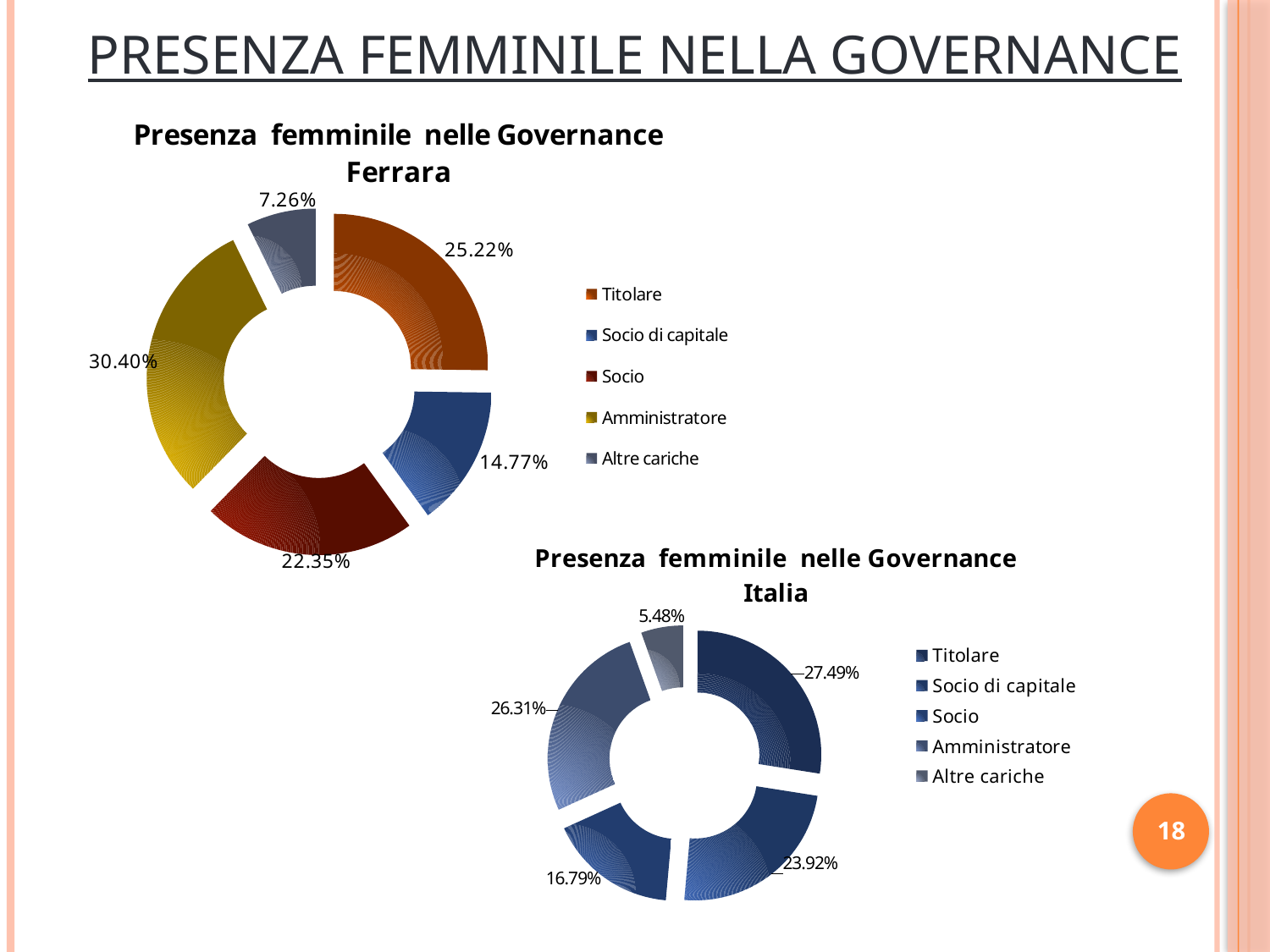
What kind of chart is the 'Presenza femminile nelle Governance Ferrara' chart? Doughnut (pie) chart In the 'Presenza femminile nelle Governance Ferrara' chart, what colour is the Amministratore slice? Yellow In the 'Presenza femminile nelle Governance Ferrara' chart, what is the value for Titolare? 25.22% In the 'Presenza femminile nelle Governance Italia' chart, which category has the largest share? Titolare In the 'Presenza femminile nelle Governance Italia' chart, what is the value for Altre cariche? 5.48% In the 'Presenza femminile nelle Governance Ferrara' chart, what is the value for Amministratore? 30.40% In the 'Presenza femminile nelle Governance Italia' chart, which is larger, Socio di capitale or Socio? Socio di capitale In the 'Presenza femminile nelle Governance Ferrara' chart, which category has the smallest share? Altre cariche In the 'Presenza femminile nelle Governance Ferrara' chart, what is the difference between Socio and Socio di capitale? 7.58% In the 'Presenza femminile nelle Governance Ferrara' chart, which category has the largest share? Amministratore In the 'Presenza femminile nelle Governance Italia' chart, what is the value for Titolare? 27.49% How many categories does the 'Presenza femminile nelle Governance Italia' chart show? 5